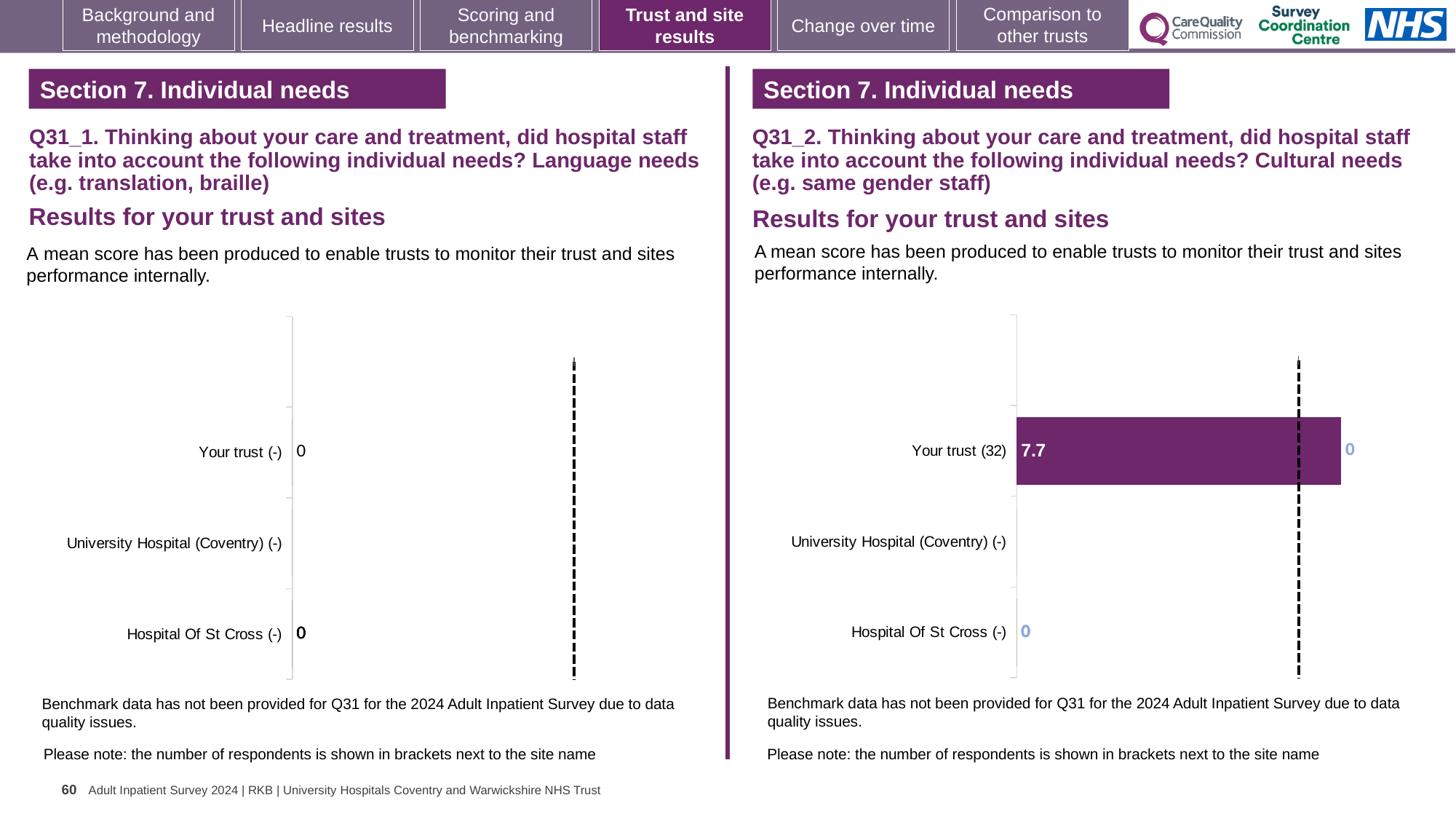
On the right chart (Q31_2, Cultural needs), what is the difference between the value for Your trust and the value for Hospital Of St Cross? 7.7 On the right chart (Q31_2, Cultural needs), how many categories are listed on the axis? 3 On the left chart (Q31_1, Language needs), what kind of chart is shown? bar chart On the left chart (Q31_1, Language needs), what value is shown for Your trust? 0 On the left chart (Q31_1, Language needs), what value is shown for Hospital Of St Cross? 0 On the right chart (Q31_2, Cultural needs), which is larger: the value for Your trust or the value for Hospital Of St Cross? Your trust On the right chart (Q31_2, Cultural needs), what value is shown for Hospital Of St Cross? 0 On the left chart (Q31_1, Language needs), how many site/trust categories are listed on the axis? 3 On the right chart (Q31_2, Cultural needs), what is the mean score for Your trust? 7.7 According to the note under both charts, why has benchmark data not been provided for Q31? due to data quality issues On the right chart (Q31_2, Cultural needs), which category has the highest value? Your trust (32) On the right chart (Q31_2, Cultural needs), how many respondents are shown in brackets next to Your trust? 32